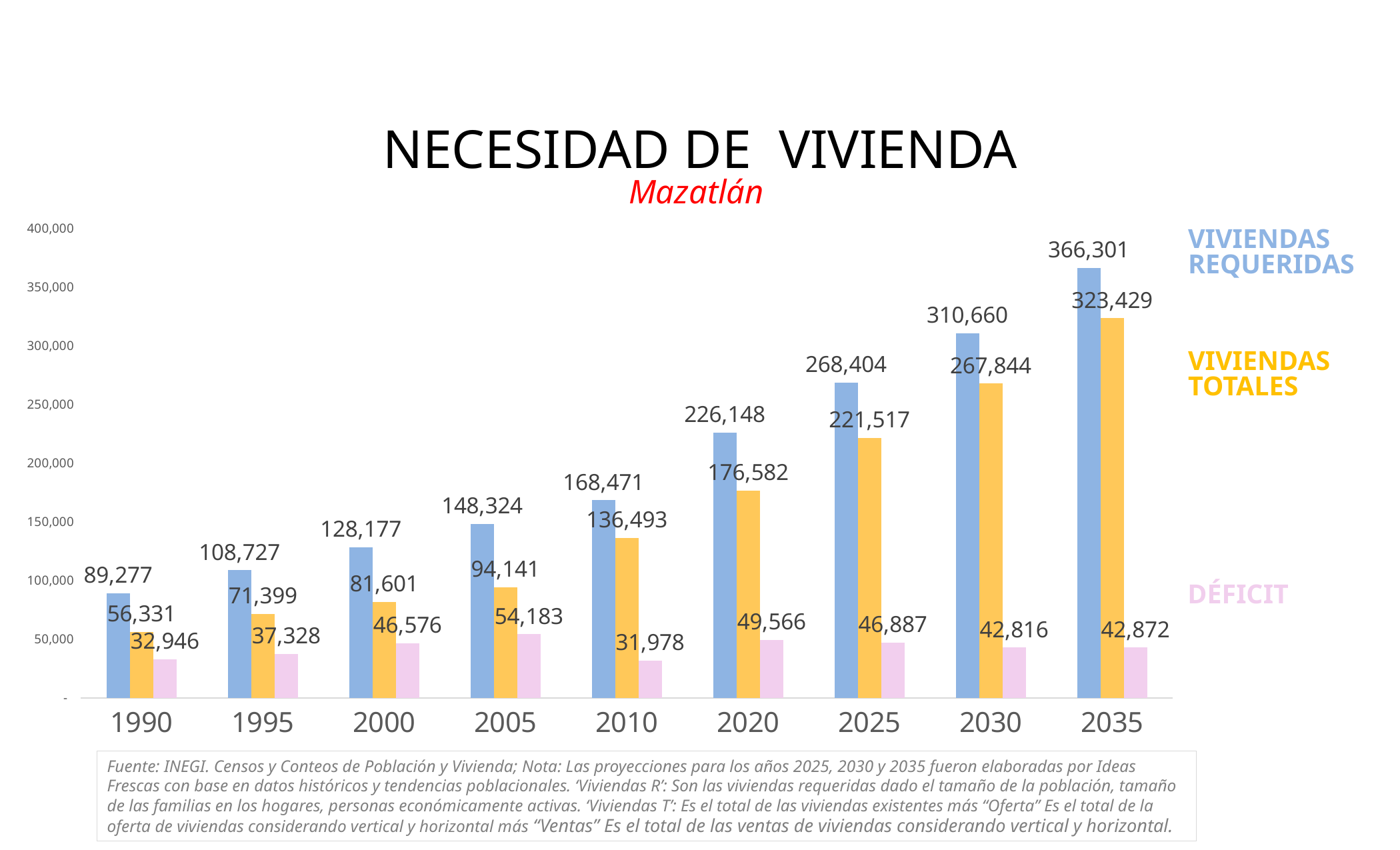
Which is larger: Viviendas Totales in 2020 or Viviendas Requeridas in 2010? Viviendas Totales in 2020 What is the difference between Viviendas Requeridas in 2030 and in 2025? 42,256 What is the difference between Viviendas Requeridas and Viviendas Totales in 2035? 42,872 In which year is the Déficit highest? 2005 What kind of chart is shown on the slide? Bar chart What is the Déficit value for 1995? 37,328 What is the value of Viviendas Totales for 2010? 136,493 How many years are shown on the x axis? 9 Do the Viviendas Requeridas values rise or fall from 1990 to 2035? Rise What is the value of Viviendas Requeridas for 2035? 366,301 In which year is the Déficit lowest? 2010 How many series does the chart show? 3